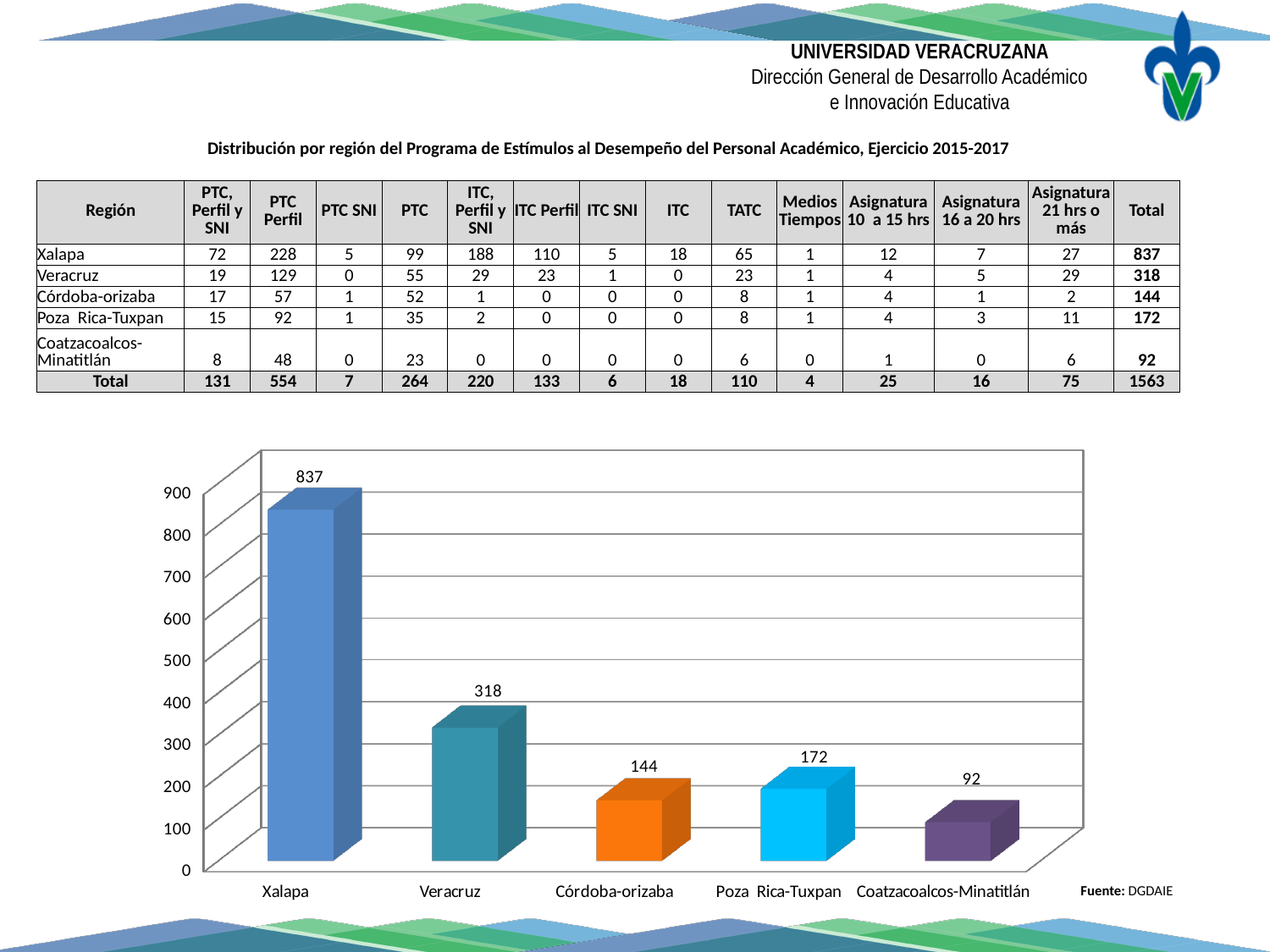
Which is larger in the bar chart, the value for Córdoba-orizaba or the value for Poza Rica-Tuxpan? Poza Rica-Tuxpan What kind of chart is shown on the slide? bar chart Which region has the highest value in the bar chart? Xalapa What is the source cited below the bar chart? DGDAIE What is the value shown for Coatzacoalcos-Minatitlán in the bar chart? 92 What is the value shown for Xalapa in the bar chart? 837 Is the value for Veracruz in the bar chart greater or less than 300? greater What is the difference between the values for Xalapa and Veracruz in the bar chart? 519 How many regions are shown in the bar chart? 5 What is the value shown for Veracruz in the bar chart? 318 What is the difference between the values for Poza Rica-Tuxpan and Córdoba-orizaba in the bar chart? 28 Which region has the lowest value in the bar chart? Coatzacoalcos-Minatitlán